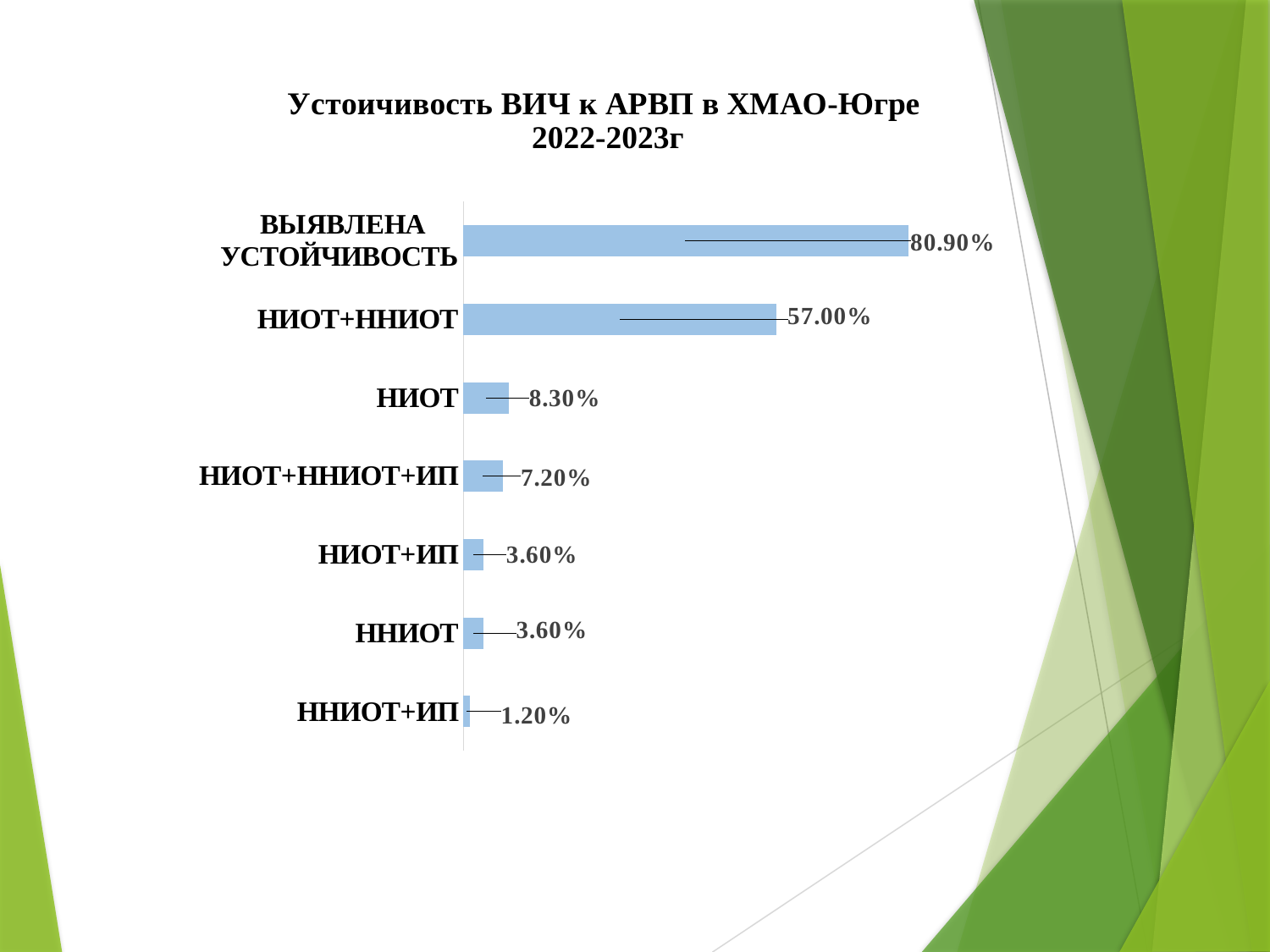
What is the value for ННИОТ+ИП? 1.20% What is the value for НИОТ+ННИОТ+ИП? 7.20% Which category has the highest value? ВЫЯВЛЕНА УСТОЙЧИВОСТЬ What is the value for НИОТ+ННИОТ? 57.00% What kind of chart is shown on the slide? Bar chart What is the value for ВЫЯВЛЕНА УСТОЙЧИВОСТЬ? 80.90% Which is larger, the value for НИОТ or the value for НИОТ+ИП? НИОТ What is the title of the chart? Устоичивость ВИЧ к АРВП в ХМАО-Югре 2022-2023г What is the difference between the values for НИОТ and НИОТ+ННИОТ+ИП? 1.10% What is the difference between the values for ВЫЯВЛЕНА УСТОЙЧИВОСТЬ and НИОТ+ННИОТ? 23.90% How many categories are shown in the chart? 7 Which category has the lowest value? ННИОТ+ИП